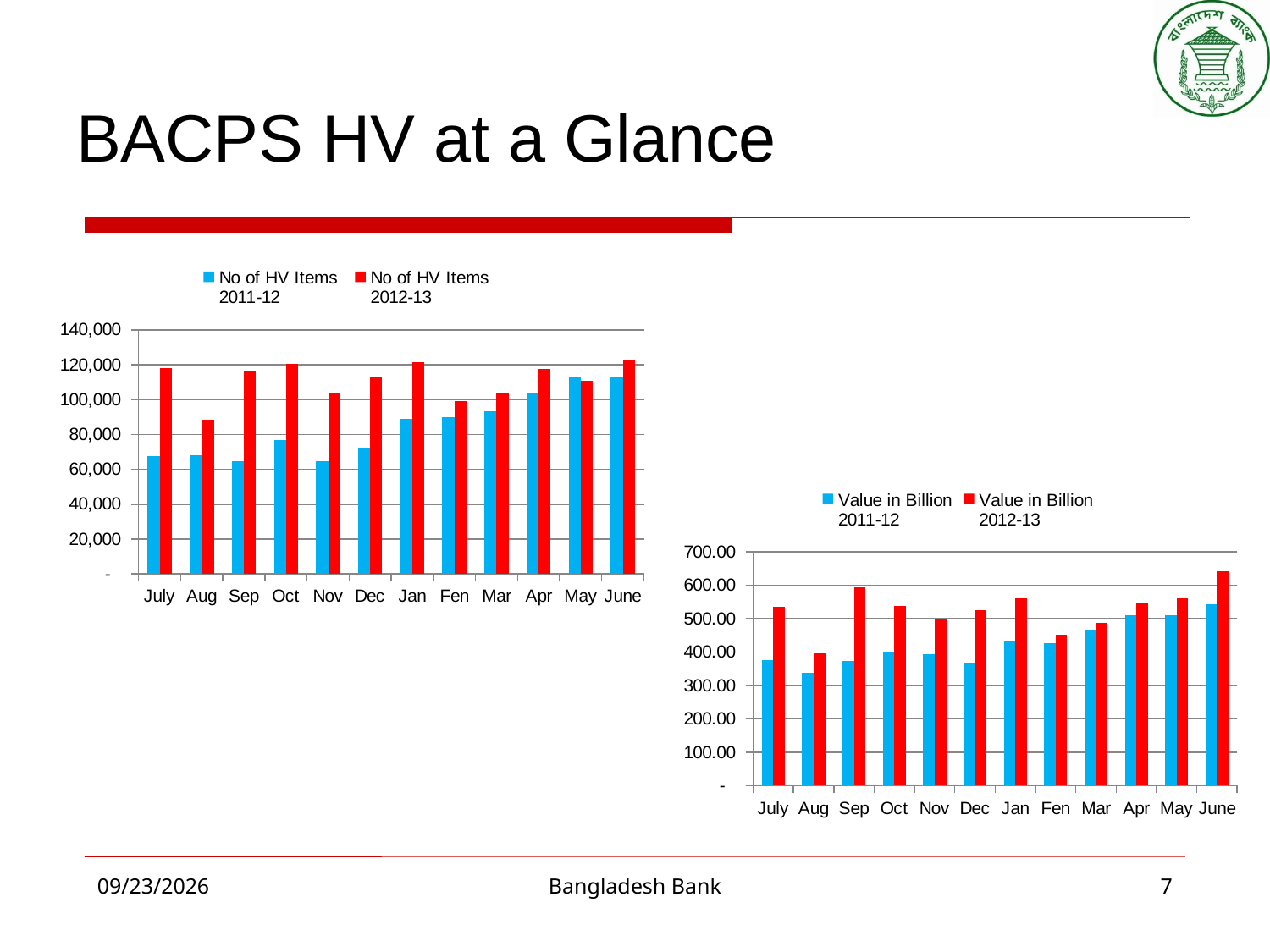
In the left chart (No of HV Items), which month has the lowest value for the 2012-13 series? Aug In the right chart (Value in Billion), which month has the lowest value for the 2011-12 series? Aug What kind of chart is the left chart (No of HV Items)? bar chart In the left chart (No of HV Items), which is larger for Aug: the 2011-12 value or the 2012-13 value? 2012-13 How many months are shown on the x axis of the right chart (Value in Billion)? 12 In the right chart (Value in Billion), which month has the highest value for the 2012-13 series? June In the left chart (No of HV Items), is the 2012-13 value for Aug greater or less than 80,000? greater What are the two series names in the legend of the right chart? Value in Billion 2011-12 and Value in Billion 2012-13 In the left chart (No of HV Items), is the 2011-12 value for July greater or less than 80,000? less In the right chart (Value in Billion), which is larger for the 2012-13 series: Sep or Oct? Sep In the right chart (Value in Billion), is the 2012-13 value for Sep greater or less than 500.00? greater How many series does the legend of the left chart (No of HV Items) list? 2